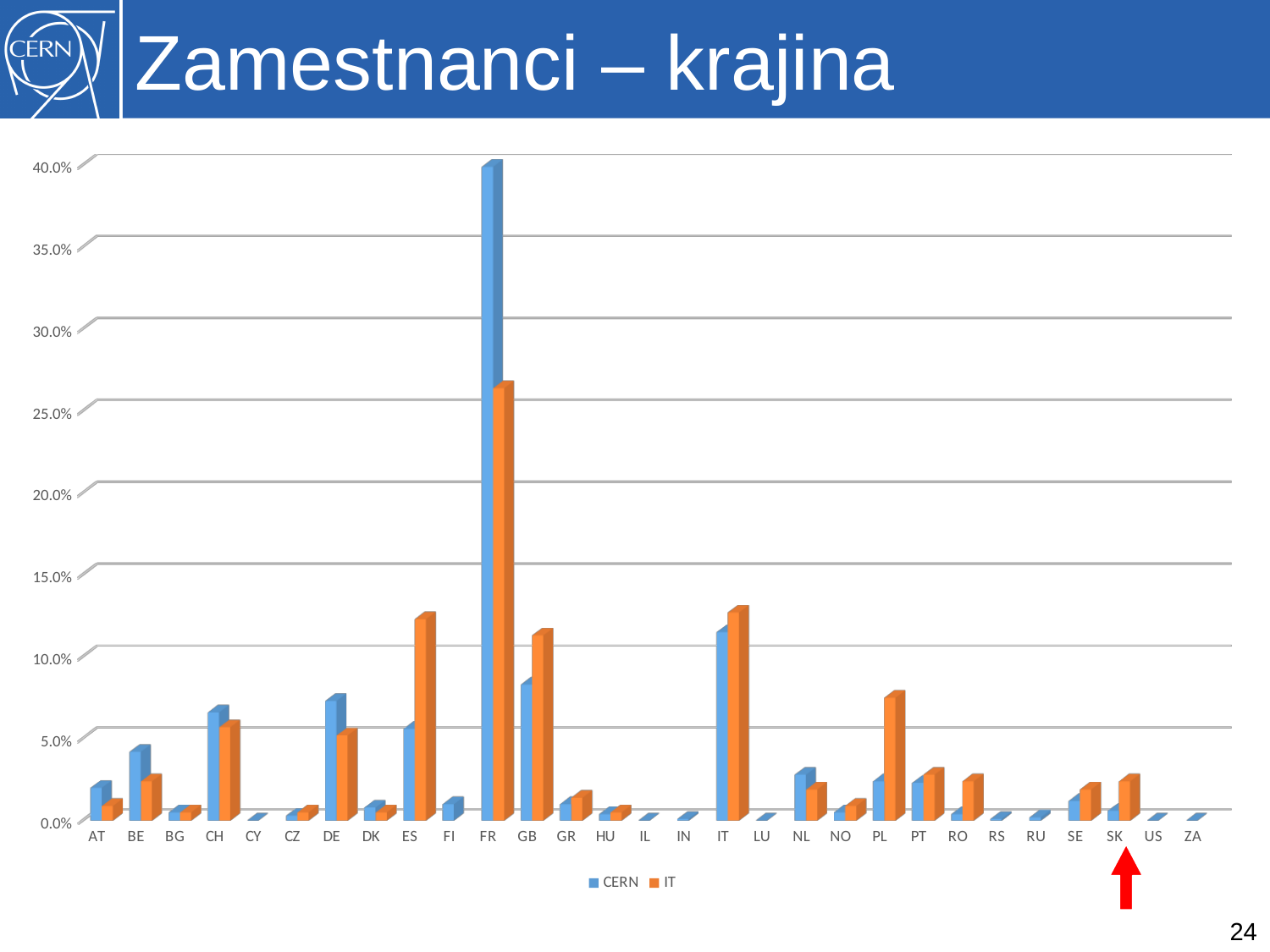
Is the IT value for ES greater or less than 10.0%? greater How many series does the legend list? 2 For DE, which series has the larger value, CERN or IT? CERN How many country categories are shown on the x axis? 29 Which country has the highest IT value? FR Which country has the highest CERN value? FR Is the IT value for FR greater or less than 30.0%? less For ES, which series has the larger value, CERN or IT? IT Is the CERN value for FR greater or less than 35.0%? greater What kind of chart is shown on the slide? bar chart For PL, which series has the larger value, CERN or IT? IT Which colour represents the IT series in the legend? orange